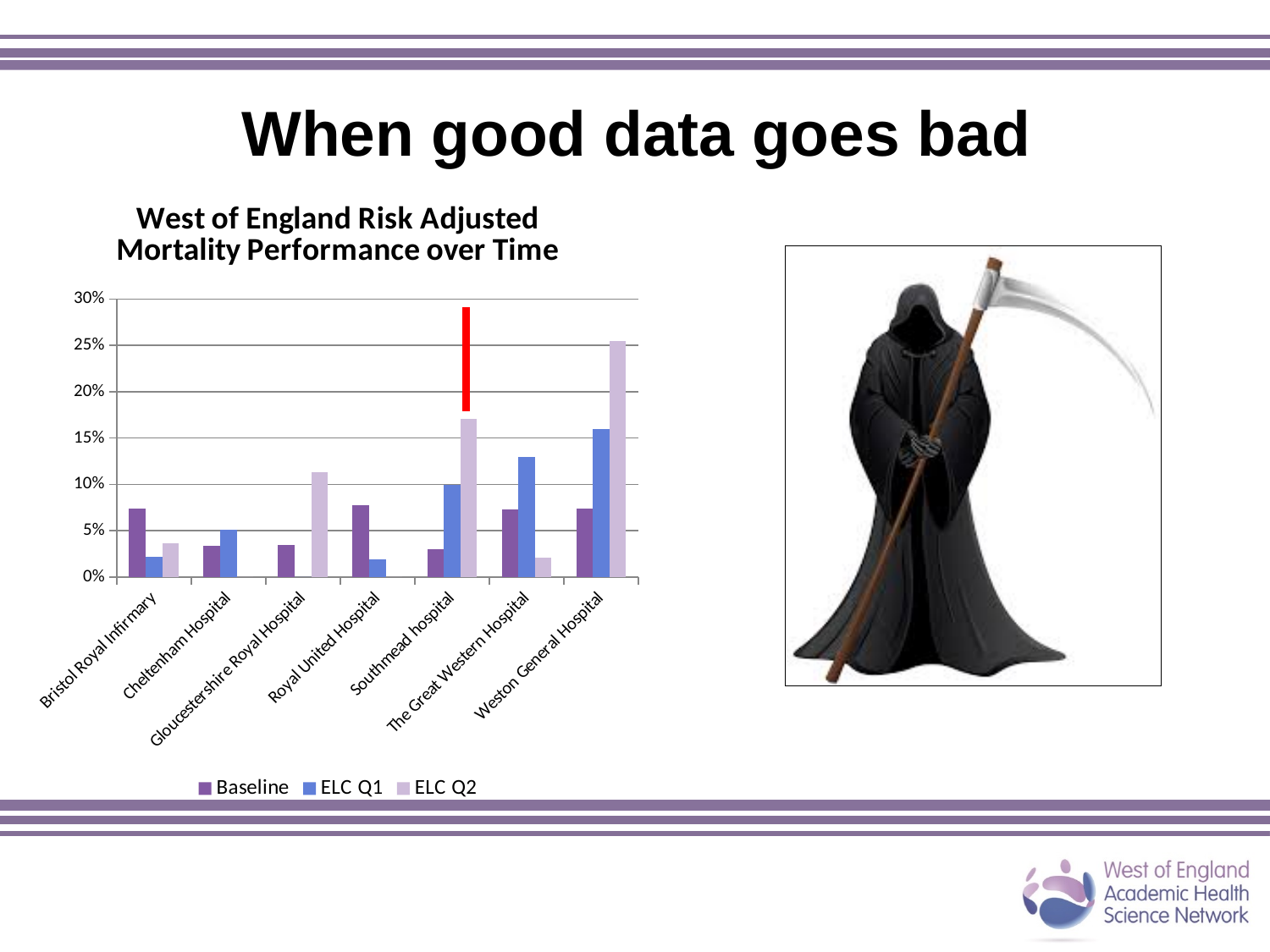
Is the ELC Q2 value for Gloucestershire Royal Hospital greater or less than 10%? greater Is the ELC Q2 value for Weston General Hospital greater or less than 20%? greater What kind of chart is shown on the slide? bar chart Is the ELC Q1 value for The Great Western Hospital greater or less than 10%? greater Which hospital has the highest ELC Q1 value? Weston General Hospital Which hospital has the highest ELC Q2 value? Weston General Hospital What is the title of the chart? West of England Risk Adjusted Mortality Performance over Time How many series does the legend list? 3 For Bristol Royal Infirmary, which is larger, the Baseline value or the ELC Q1 value? Baseline How many hospitals are shown on the x axis? 7 Which is larger, the ELC Q2 value for Southmead hospital or the ELC Q2 value for Weston General Hospital? Weston General Hospital